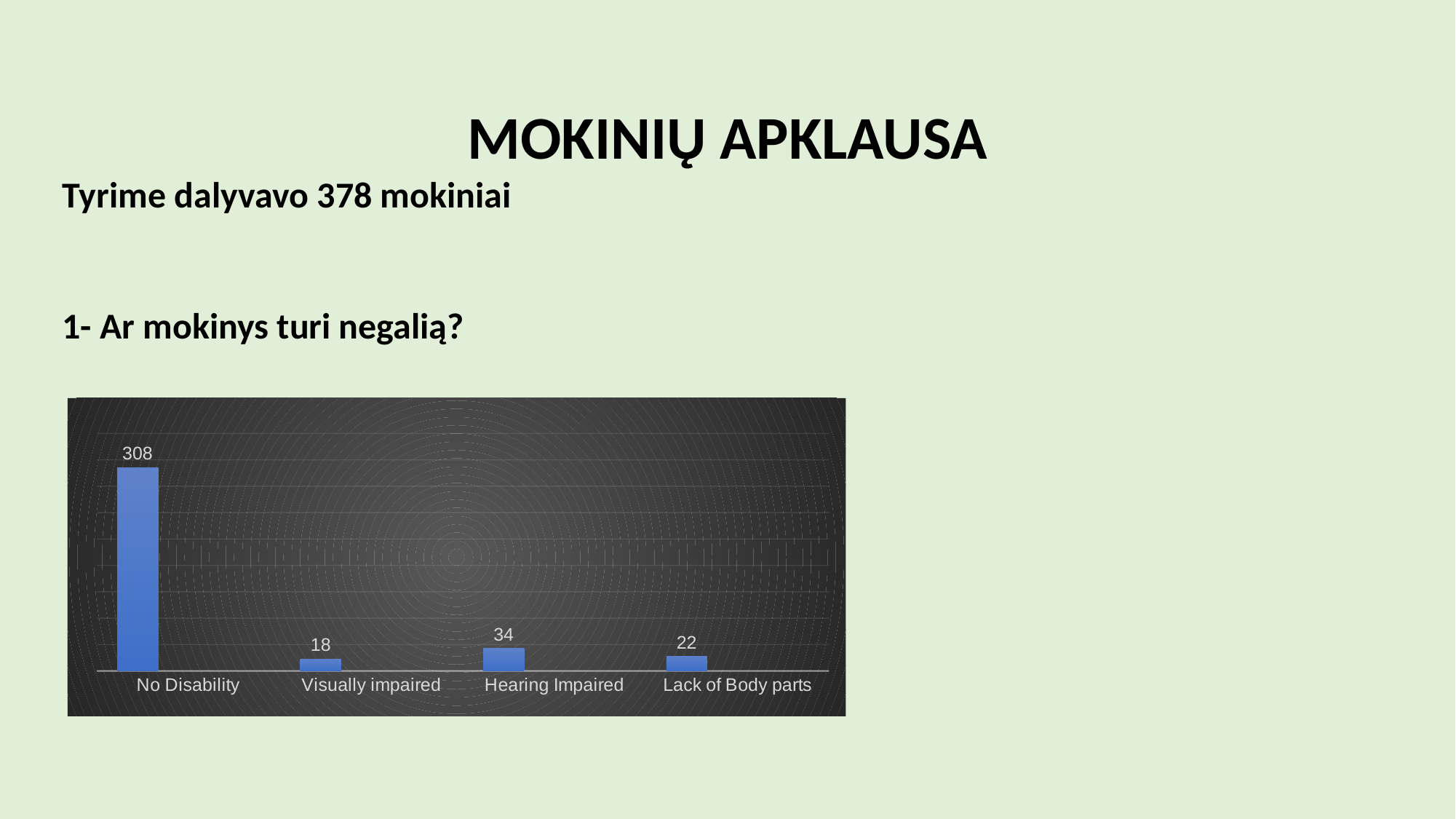
What is the difference between the values for No Disability and Hearing Impaired? 274 What is the value for Visually impaired? 18 What is the difference between the values for Hearing Impaired and Lack of Body parts? 12 How many categories are shown in the chart? 4 Which category has the highest value? No Disability Which is larger, the value for Hearing Impaired or the value for Visually impaired? Hearing Impaired Which category has the lowest value? Visually impaired What is the total of all four values shown in the chart? 382 What is the value for Lack of Body parts? 22 What is the value for No Disability? 308 What kind of chart is shown on the slide? bar chart What is the value for Hearing Impaired? 34